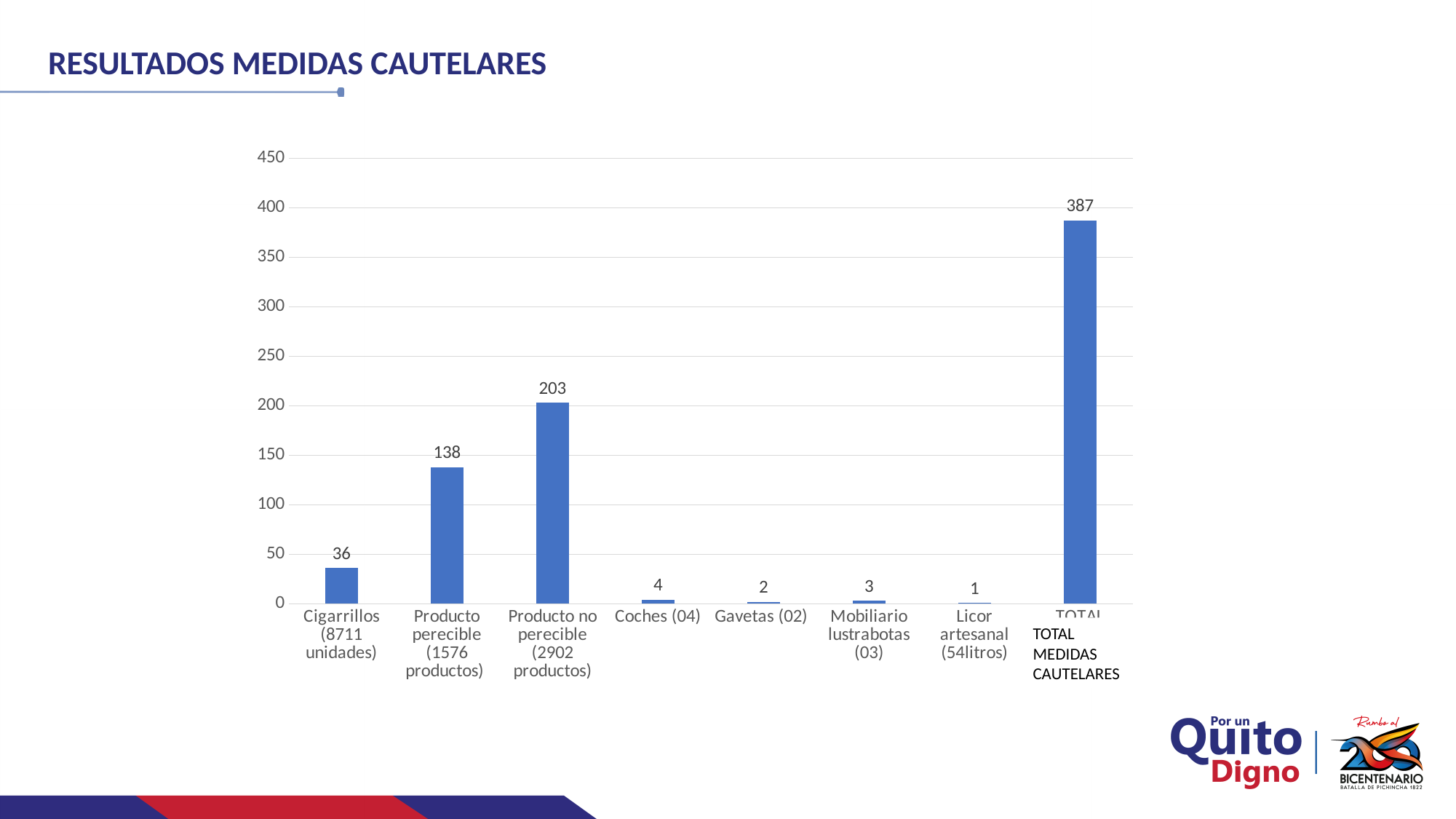
What is the value for Coches (04)? 4 What kind of chart is shown on the slide? Bar chart Which category has the lowest value? Licor artesanal (54litros) What is the title of the slide? RESULTADOS MEDIDAS CAUTELARES How many categories are shown on the x axis? 8 Excluding the TOTAL bar, which category has the highest value? Producto no perecible (2902 productos) What is the difference between Producto no perecible (2902 productos) and Producto perecible (1576 productos)? 65 What is the value for Cigarrillos (8711 unidades)? 36 What is the value for Producto perecible (1576 productos)? 138 Which is larger, Mobiliario lustrabotas (03) or Gavetas (02)? Mobiliario lustrabotas (03) What is the value for Producto no perecible (2902 productos)? 203 What is the value for TOTAL MEDIDAS CAUTELARES? 387